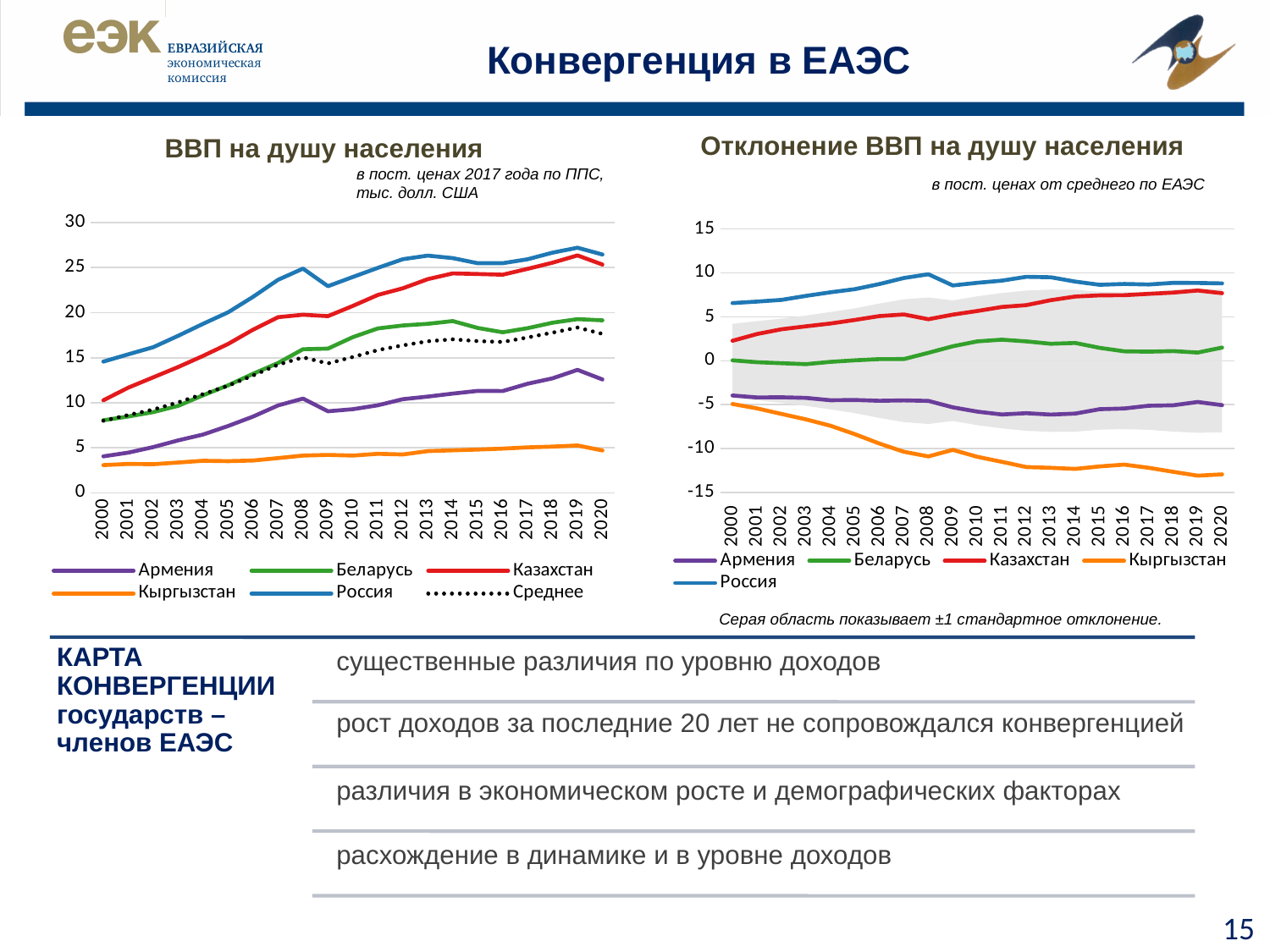
How many series does the legend of the left chart "ВВП на душу населения" list? 6 In the right chart "Отклонение ВВП на душу населения", is the value for Кыргызстан in 2020 greater or less than -10? less How many series does the legend of the right chart "Отклонение ВВП на душу населения" list? 5 How many years are plotted along the x axis of the left chart "ВВП на душу населения"? 21 In the left chart "ВВП на душу населения", is the value for Россия in 2020 greater or less than 25? greater In the left chart "ВВП на душу населения", is the value for Казахстан in 2000 greater or less than 15? less What kind of chart is the left chart titled "ВВП на душу населения"? line chart In the right chart "Отклонение ВВП на душу населения", which is larger in 2020: Беларусь or Армения? Беларусь According to the note under the right chart, what does the grey area show? ±1 стандартное отклонение In the right chart "Отклонение ВВП на душу населения", does the line for Кыргызстан rise or fall from 2000 to 2020? fall In the left chart "ВВП на душу населения", which country has the lowest value in 2020? Кыргызстан In the left chart "ВВП на душу населения", which country has the highest value in 2020? Россия